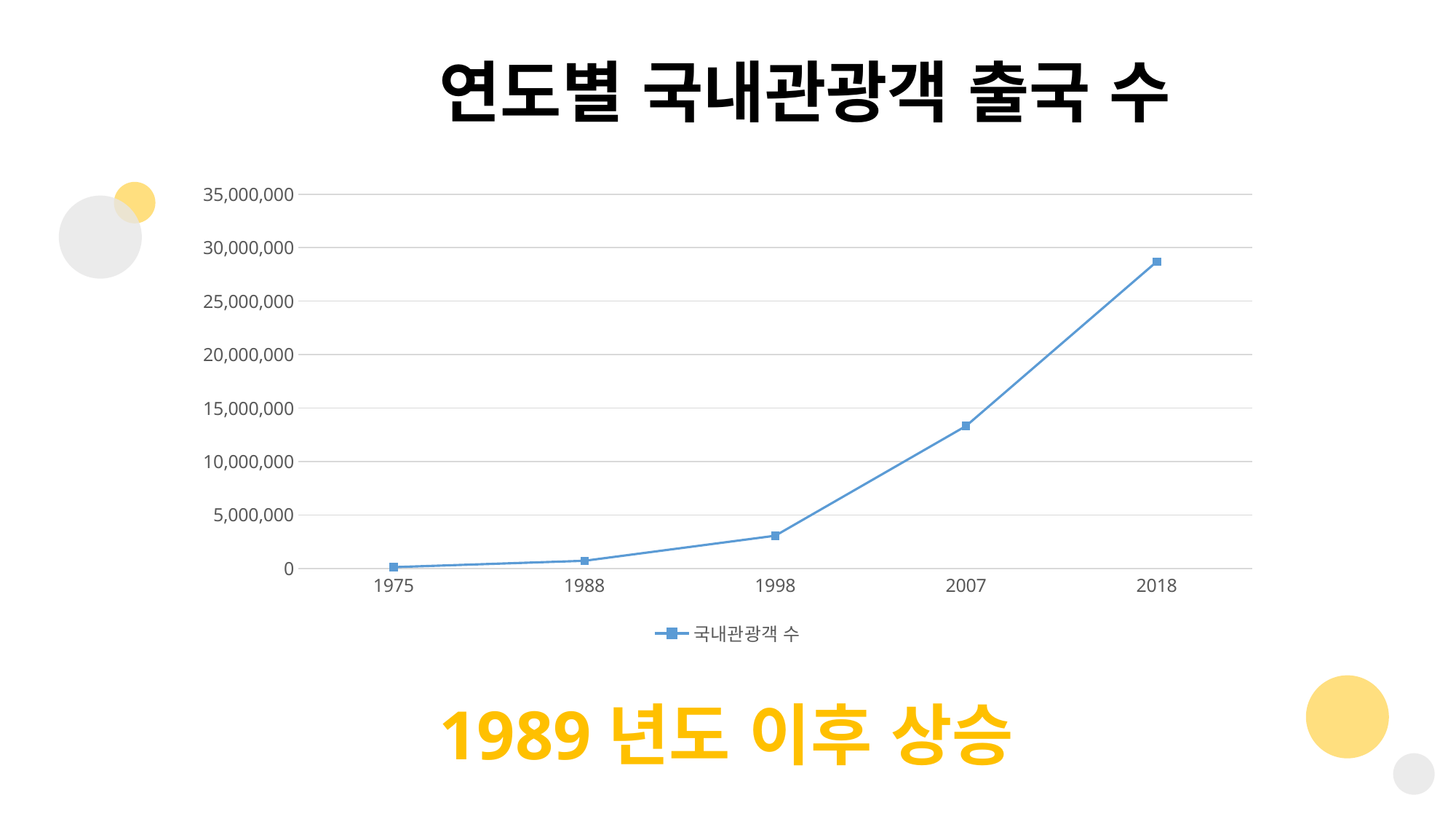
Which year has the larger value, 2007 or 1998? 2007 Which year has the highest value? 2018 Is the value for 2007 greater or less than 15,000,000? less What is the title of the chart? 연도별 국내관광객 출국 수 Do the values rise or fall from 1975 to 2018? rise How many years are plotted on the x axis? 5 Which year has the lowest value? 1975 Is the value for 2018 greater or less than 25,000,000? greater Is the value for 1998 greater or less than 5,000,000? less What kind of chart is shown on the slide? line chart What is the name of the series shown in the legend? 국내관광객 수 How many series does the legend list? 1